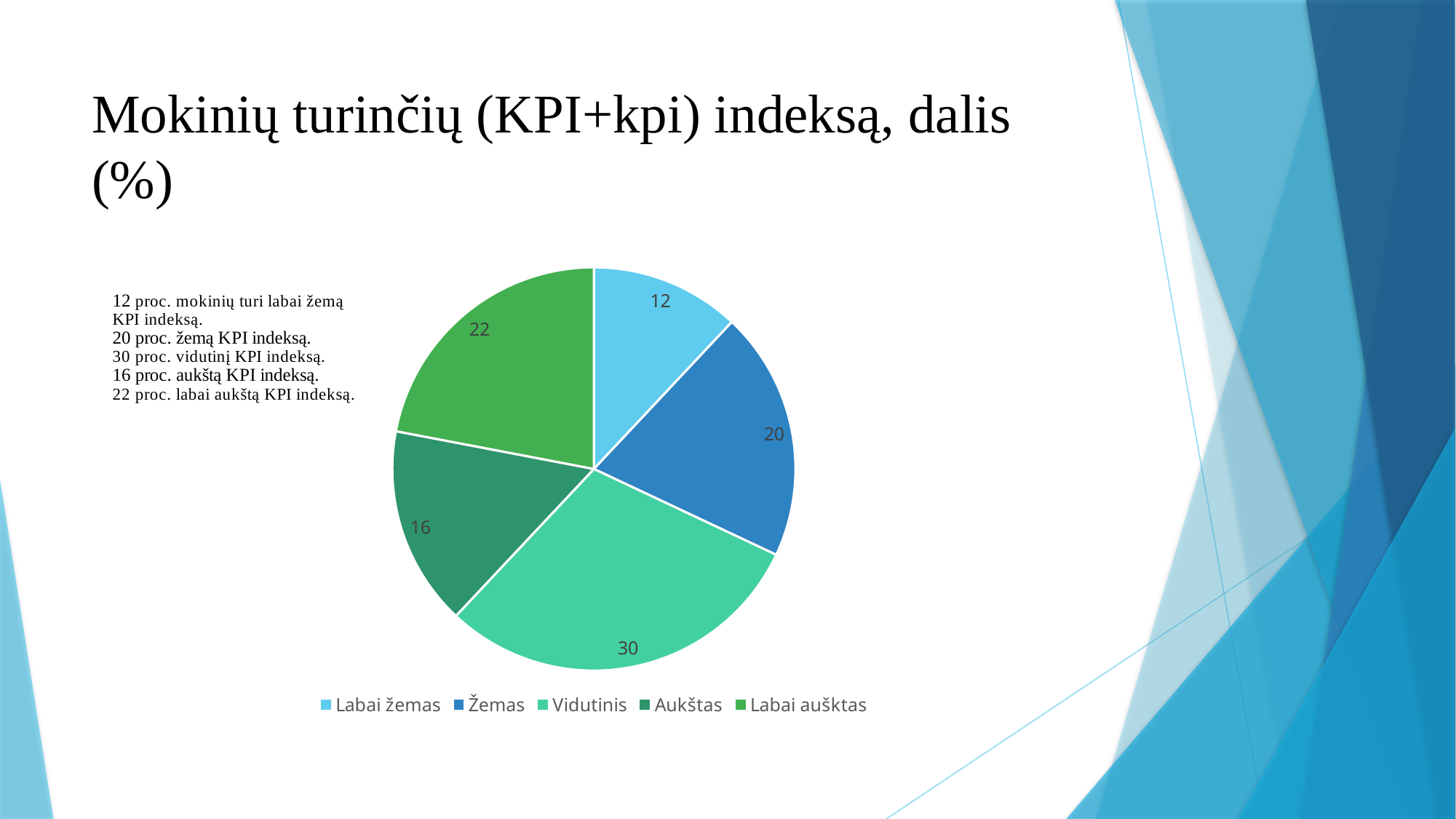
Which category has the largest slice? Vidutinis What is the difference between the values for Vidutinis and Žemas? 10 What is the title of the chart? Mokinių turinčių (KPI+kpi) indeksą, dalis (%) What is the value for Aukštas? 16 What kind of chart is shown on the slide? pie chart Which category has the smallest slice? Labai žemas What is the value for Vidutinis? 30 Which is larger, the value for Žemas or the value for Aukštas? Žemas What is the value for Labai žemas? 12 How many slices does the pie chart have? 5 What is the value for Labai auškтas? 22 What share of the pie does the Labai auškтas slice represent? 22%